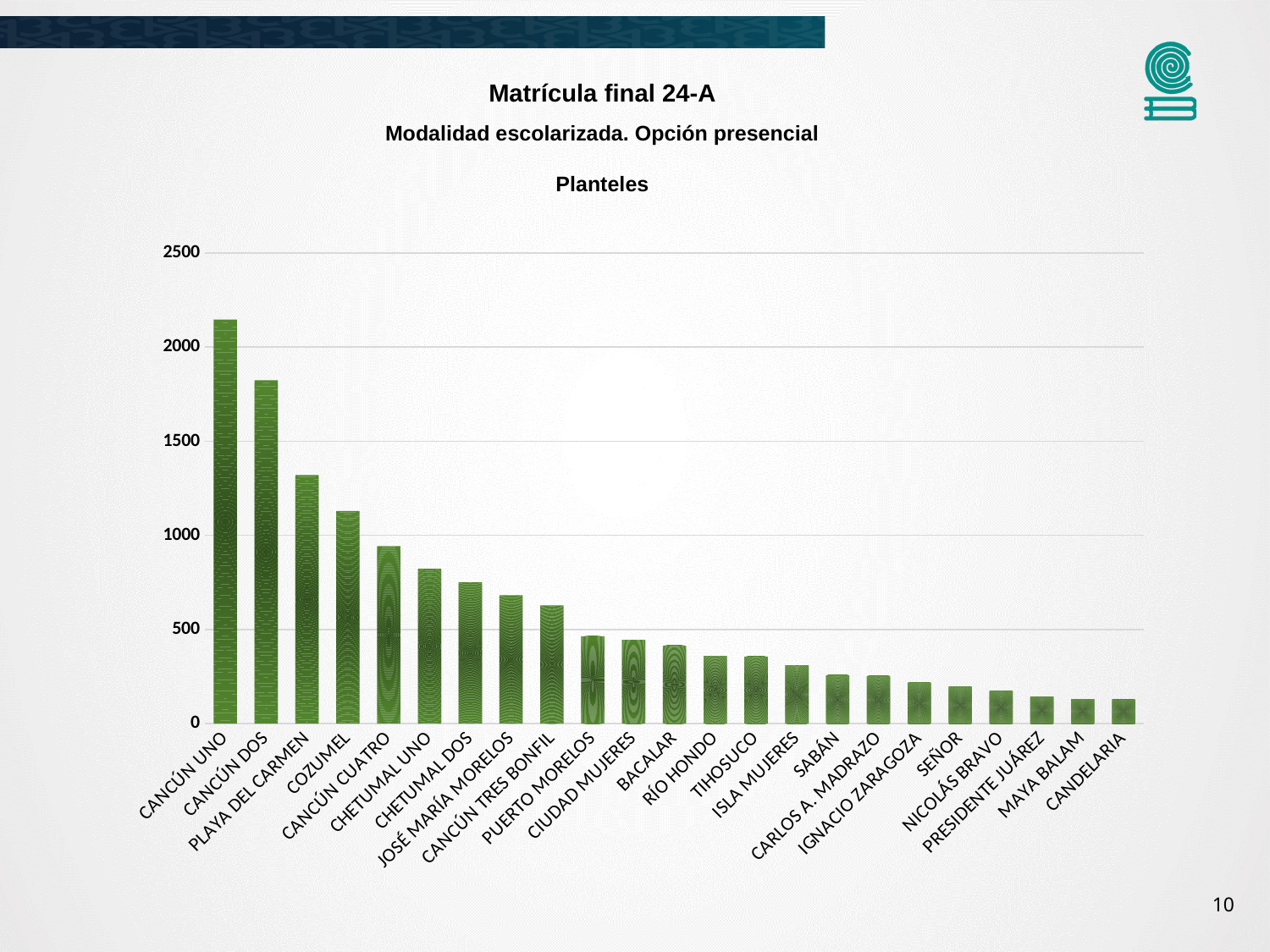
How many planteles (categories) are plotted on the chart? 23 Do the values rise or fall moving from left to right along the x axis? fall Which plantel has the highest value on the chart? CANCÚN UNO Which has the larger value, CANCÚN DOS or PLAYA DEL CARMEN? CANCÚN DOS Is the value for BACALAR greater or less than 500? less Is the value for COZUMEL greater or less than 1000? greater What is the title shown directly above the chart? Planteles What kind of chart is shown on the slide? bar chart Is the value for CANCÚN DOS greater or less than 2000? less